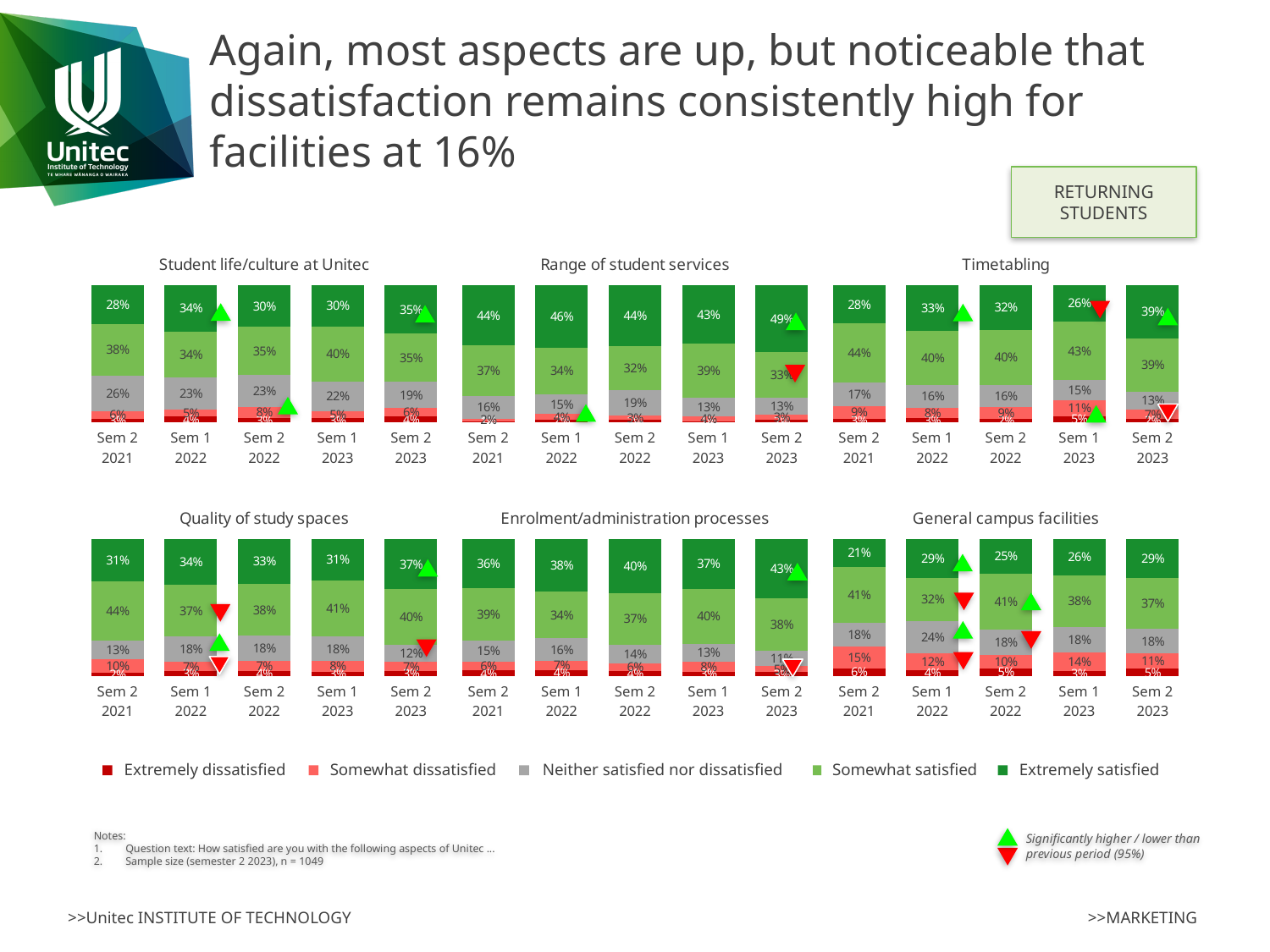
In the 'General campus facilities' chart, what is the difference between the 'Extremely satisfied' values for Sem 1 2022 and Sem 2 2021? 8% In the 'General campus facilities' chart, what is the 'Somewhat dissatisfied' value for Sem 2 2021? 15% In the 'Quality of study spaces' chart, what is the 'Neither satisfied nor dissatisfied' value for Sem 2 2023? 12% In the 'Timetabling' chart, which semester has the lowest 'Extremely satisfied' value? Sem 1 2023 In the 'Range of student services' chart, what is the 'Extremely satisfied' value for Sem 2 2023? 49% In the 'Enrolment/administration processes' chart, which is larger: the 'Extremely satisfied' value for Sem 2 2023 or for Sem 2 2021? Sem 2 2023 What kind of chart is used for 'General campus facilities'? Stacked bar chart In the 'Student life/culture at Unitec' chart, what is the 'Extremely satisfied' value for Sem 2 2023? 35% In the 'Timetabling' chart, which semester has the highest 'Extremely satisfied' value? Sem 2 2023 How many series does the legend list? 5 In the 'Range of student services' chart, what is the 'Somewhat satisfied' value for Sem 1 2023? 39% How many semesters are shown in the 'Quality of study spaces' chart? 5